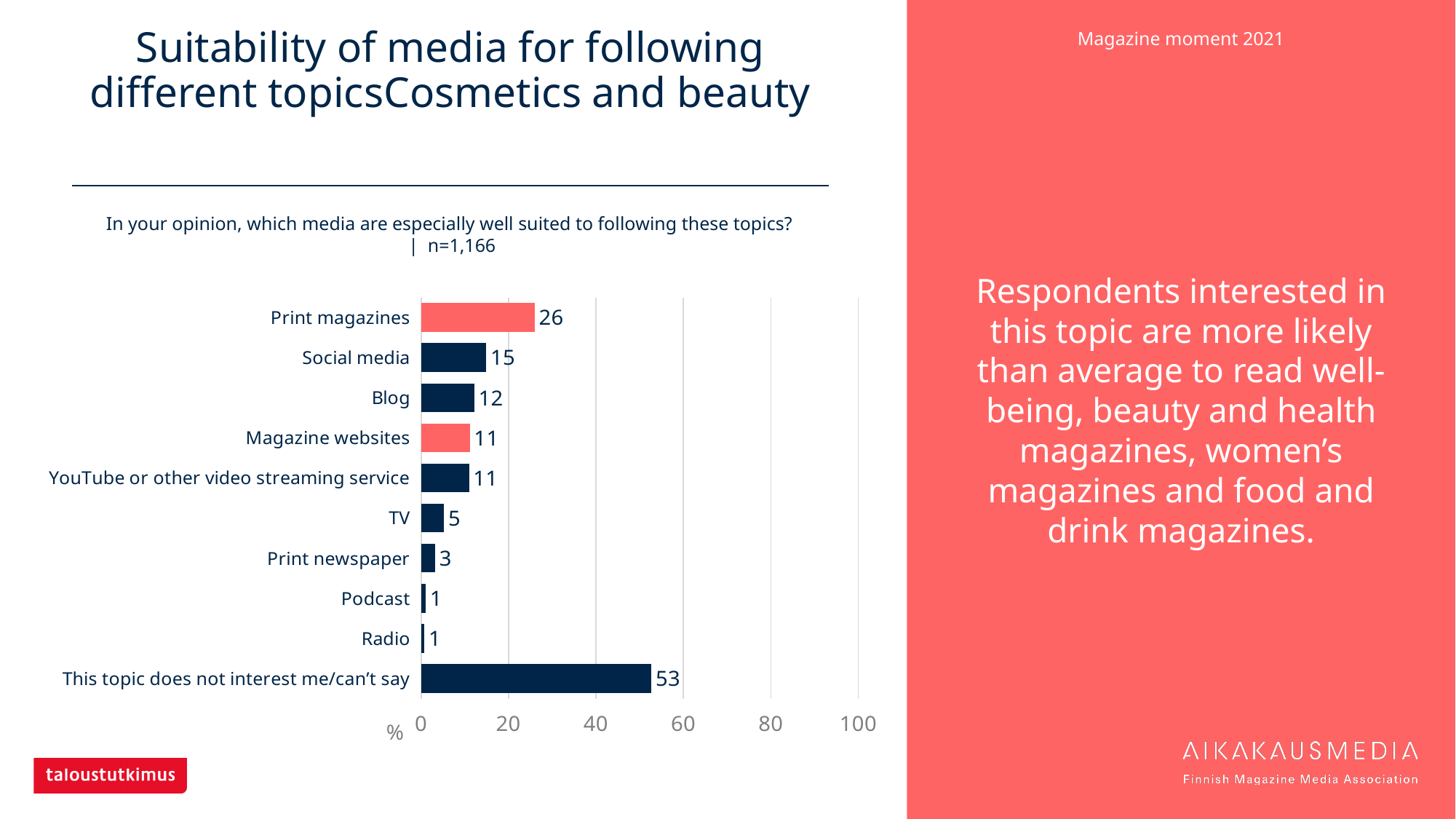
Is the value for 'This topic does not interest me/can't say' greater or less than 40? greater What kind of chart is shown on the slide? Bar chart What is the value for TV? 5 Which is larger, the value for Blog or the value for TV? Blog What is the value for 'This topic does not interest me/can't say'? 53 How many categories are shown in the chart? 10 What is the sample size (n) stated above the chart? n=1,166 What is the difference between the values for Print magazines and Social media? 11 What is the value for Print magazines? 26 Which media category (excluding 'This topic does not interest me/can't say') has the highest value? Print magazines What is the value for Social media? 15 Which category has the highest value? This topic does not interest me/can't say